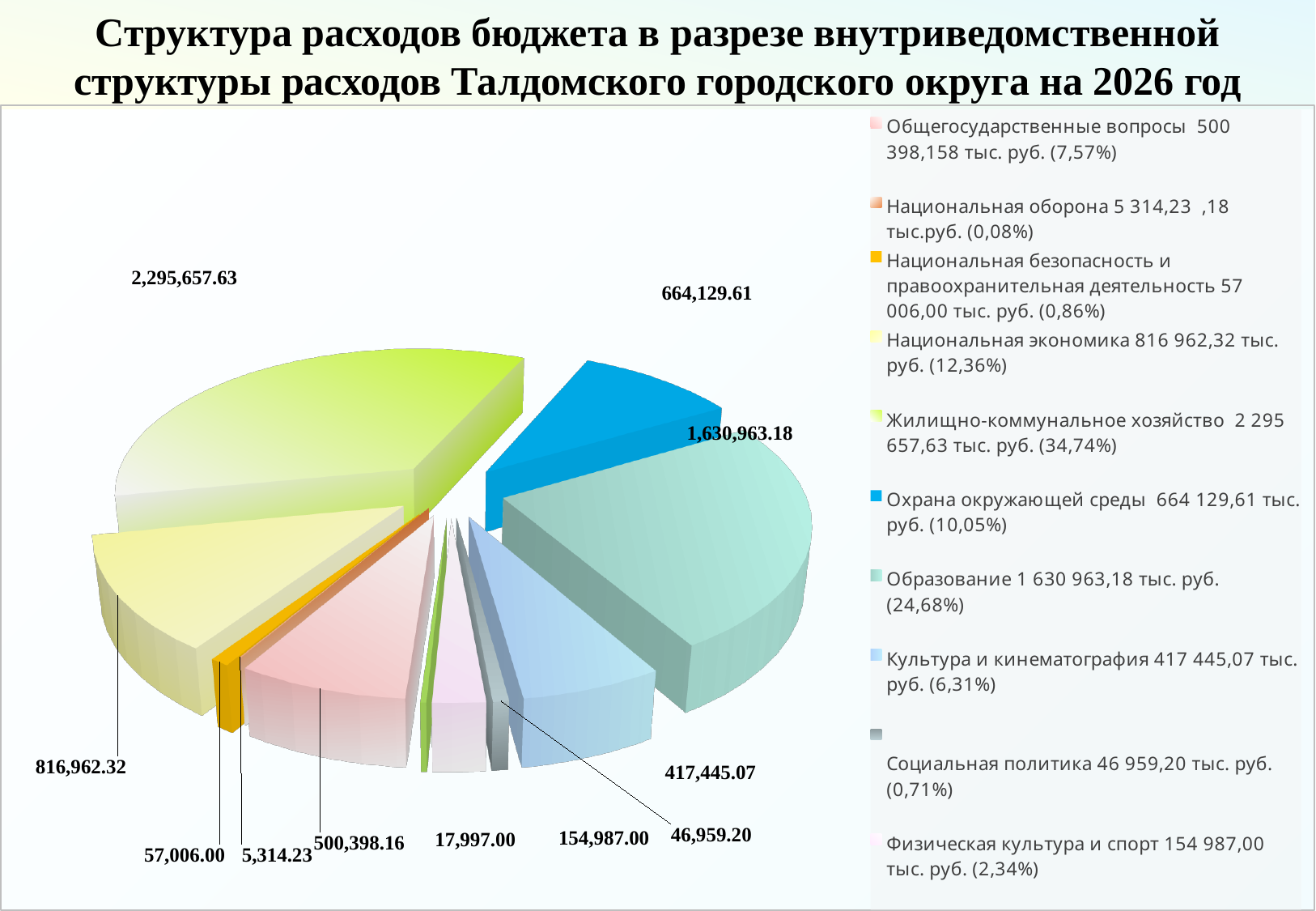
How many entries does the legend list? 10 Which category has the largest slice of the pie? Жилищно-коммунальное хозяйство What is the value labelled for Жилищно-коммунальное хозяйство? 2,295,657.63 What is the value labelled for Социальная политика? 46,959.20 What is the value labelled for Образование? 1,630,963.18 What kind of chart is shown on the slide? pie chart What share of the pie does Образование account for, according to the legend? 24,68% What share of the pie does Национальная экономика account for, according to the legend? 12,36% What colour is the slice for Охрана окружающей среды? blue Which category has the smallest slice of the pie? Национальная оборона What is the difference between the values for Жилищно-коммунальное хозяйство and Образование? 664,694.45 Which is larger: Охрана окружающей среды or Культура и кинематография? Охрана окружающей среды